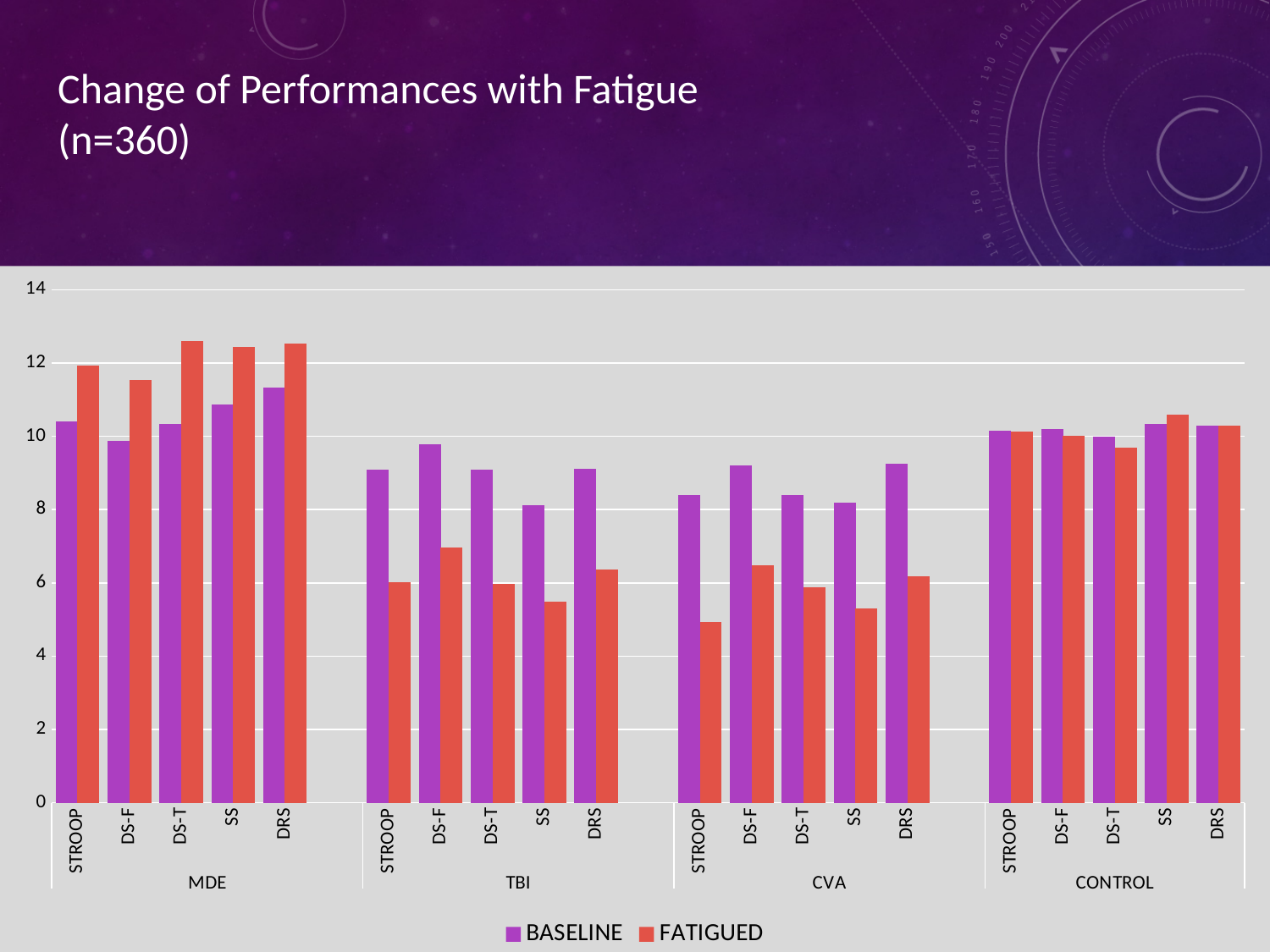
What are the two series named in the legend? BASELINE and FATIGUED What is the title of the chart? Change of Performances with Fatigue (n=360) For STROOP in the TBI group, which is larger, the BASELINE or the FATIGUED value? BASELINE Is the FATIGUED value for DS-T in the MDE group greater or less than 12? greater How many participant groups (MDE, TBI, CVA, CONTROL) are shown along the x axis? 4 What kind of chart is shown on the slide? Bar chart Is the FATIGUED value for STROOP in the CVA group greater or less than 6? less Is the BASELINE value for DS-F in the TBI group greater or less than 8? greater How many series does the legend list? 2 For SS in the MDE group, which is larger, the BASELINE or the FATIGUED value? FATIGUED Which bar has the lowest FATIGUED value on the whole chart? STROOP in the CVA group